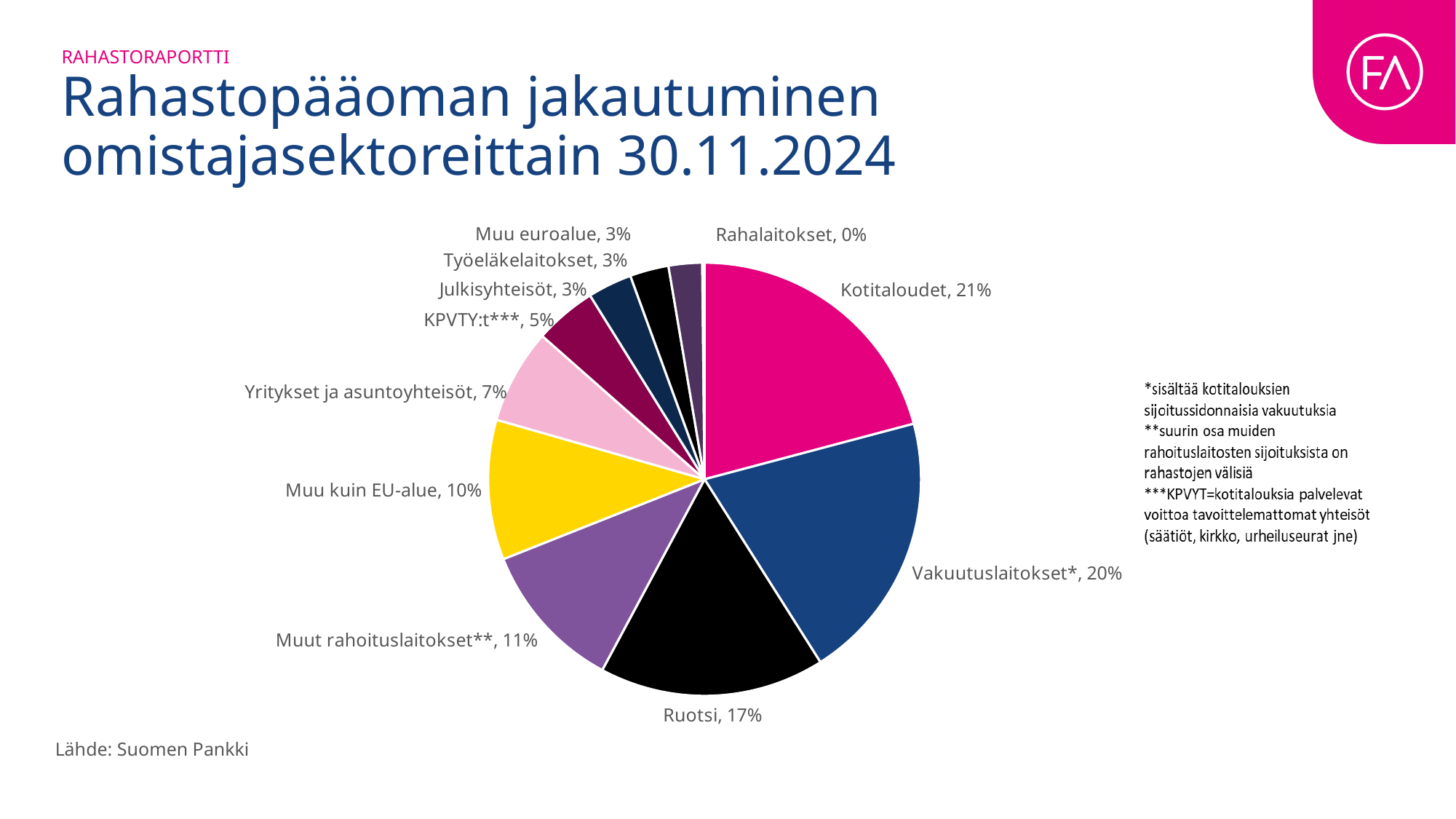
Which is larger, the share for Ruotsi or the share for Muu kuin EU-alue? Ruotsi What kind of chart is shown on the slide? pie chart What is the value shown for Ruotsi? 17% What is the title of the slide containing the chart? Rahastopääoman jakautuminen omistajasektoreittain 30.11.2024 How many categories are shown in the pie chart? 11 What share of the pie does Kotitaloudet hold? 21% Which category has the largest share of the pie? Kotitaloudet What is the combined share of Julkisyhteisöt, Työeläkelaitokset and Muu euroalue? 9% What is the difference between the shares of Vakuutuslaitokset* and Muut rahoituslaitokset**? 9 percentage points What is the value shown for Muu kuin EU-alue? 10% Which category has the smallest share of the pie? Rahalaitokset What is the value shown for Yritykset ja asuntoyhteisöt? 7%